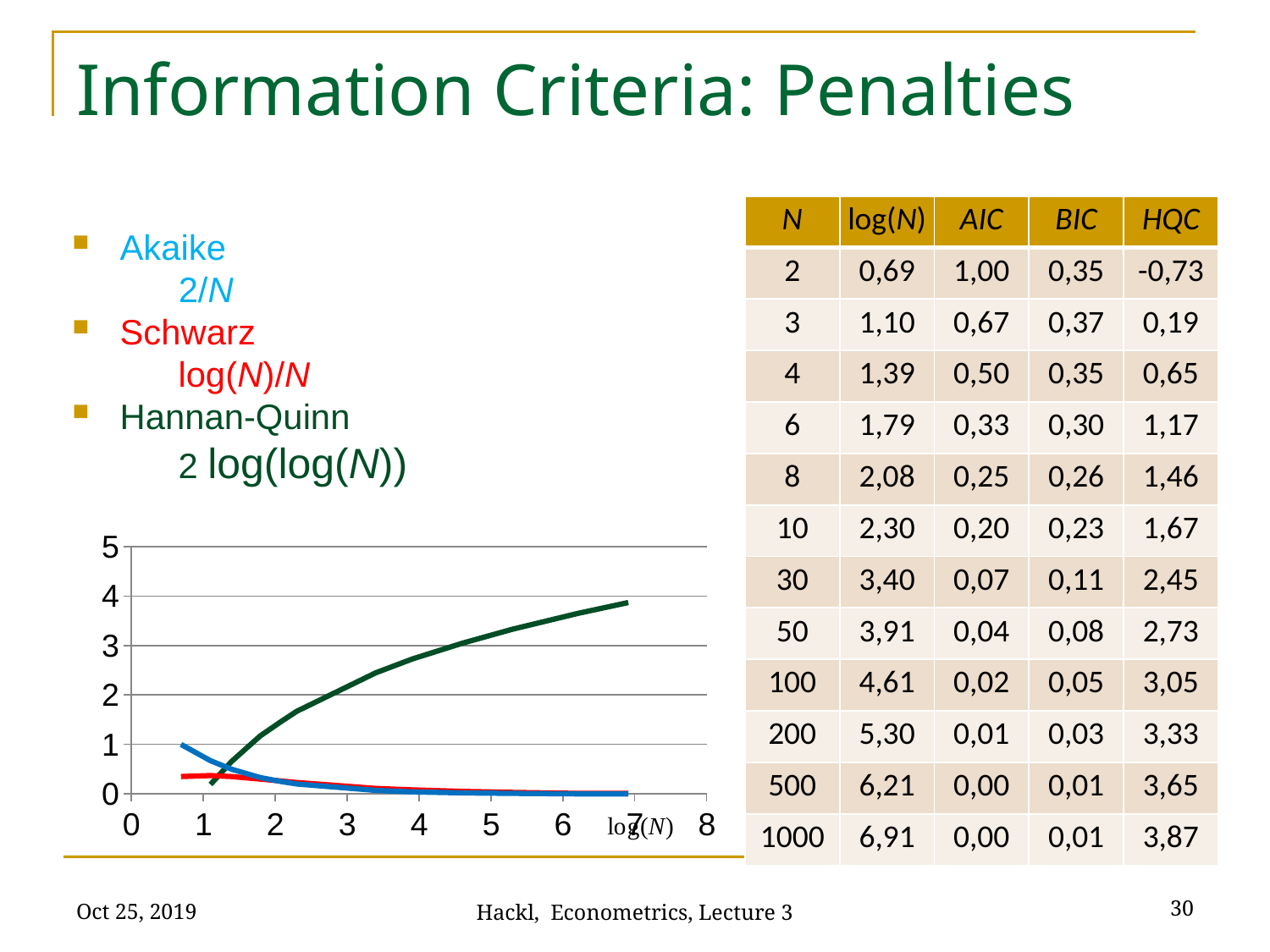
How many lines are plotted in the chart? 3 Which line has the highest value at the left end of the chart? blue line Which line has the highest value at the right end of the chart? green line Is the value of the blue line at log(N) = 1 greater or less than 0.5? greater Does the green line rise or fall as log(N) increases? rises What is the highest tick value shown on the y axis of the chart? 5 Is the value of the green line at log(N) = 2 greater or less than 2? less At log(N) = 6, which line is higher, the green line or the blue line? green line What kind of chart is shown at the bottom left of the slide? line chart What is the label on the x axis of the chart? log(N) Does the blue line rise or fall as log(N) increases? falls Is the value of the green line at log(N) = 7 greater or less than 3? greater